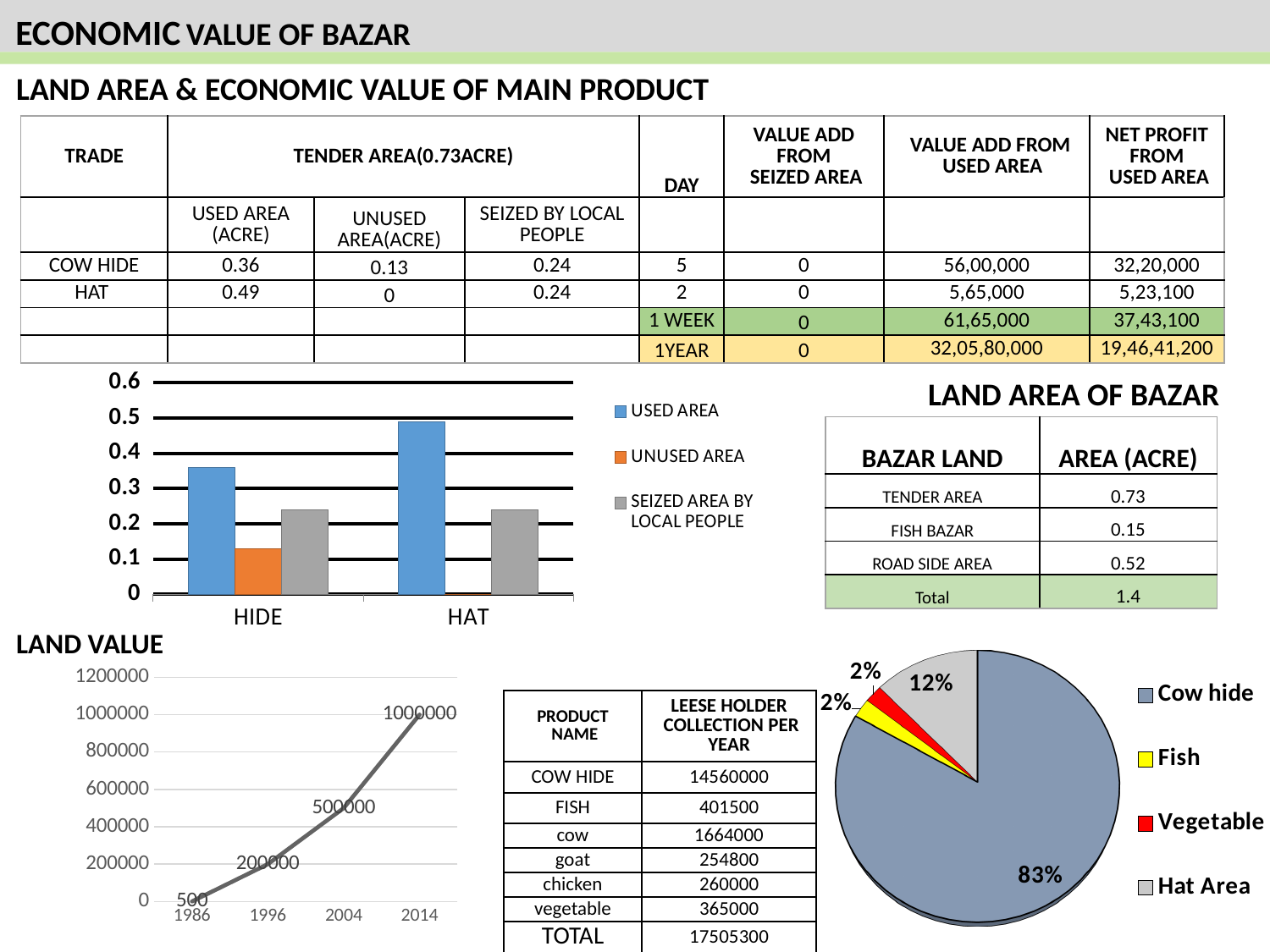
In the pie chart at the bottom right, what share does Cow hide have? 83% What kind of chart is the chart at the left of the slide showing HIDE and HAT? bar chart In the LAND VALUE line chart, what is the difference between the values for 2014 and 2004? 500000 How many data points are plotted in the LAND VALUE line chart? 4 In the LAND VALUE line chart, what is the value for 2014? 1000000 In the HIDE/HAT bar chart, is the USED AREA value for HAT greater or less than 0.4? greater In the pie chart at the bottom right, which slice is the largest? Cow hide In the HIDE/HAT bar chart, is the UNUSED AREA value for HIDE greater or less than 0.2? less In the LAND VALUE line chart, what is the value for 1996? 200000 How many series does the legend of the HIDE/HAT bar chart list? 3 In the LAND VALUE line chart, do the values rise or fall from 1986 to 2014? rise In the HIDE/HAT bar chart, which category has the larger USED AREA bar, HIDE or HAT? HAT